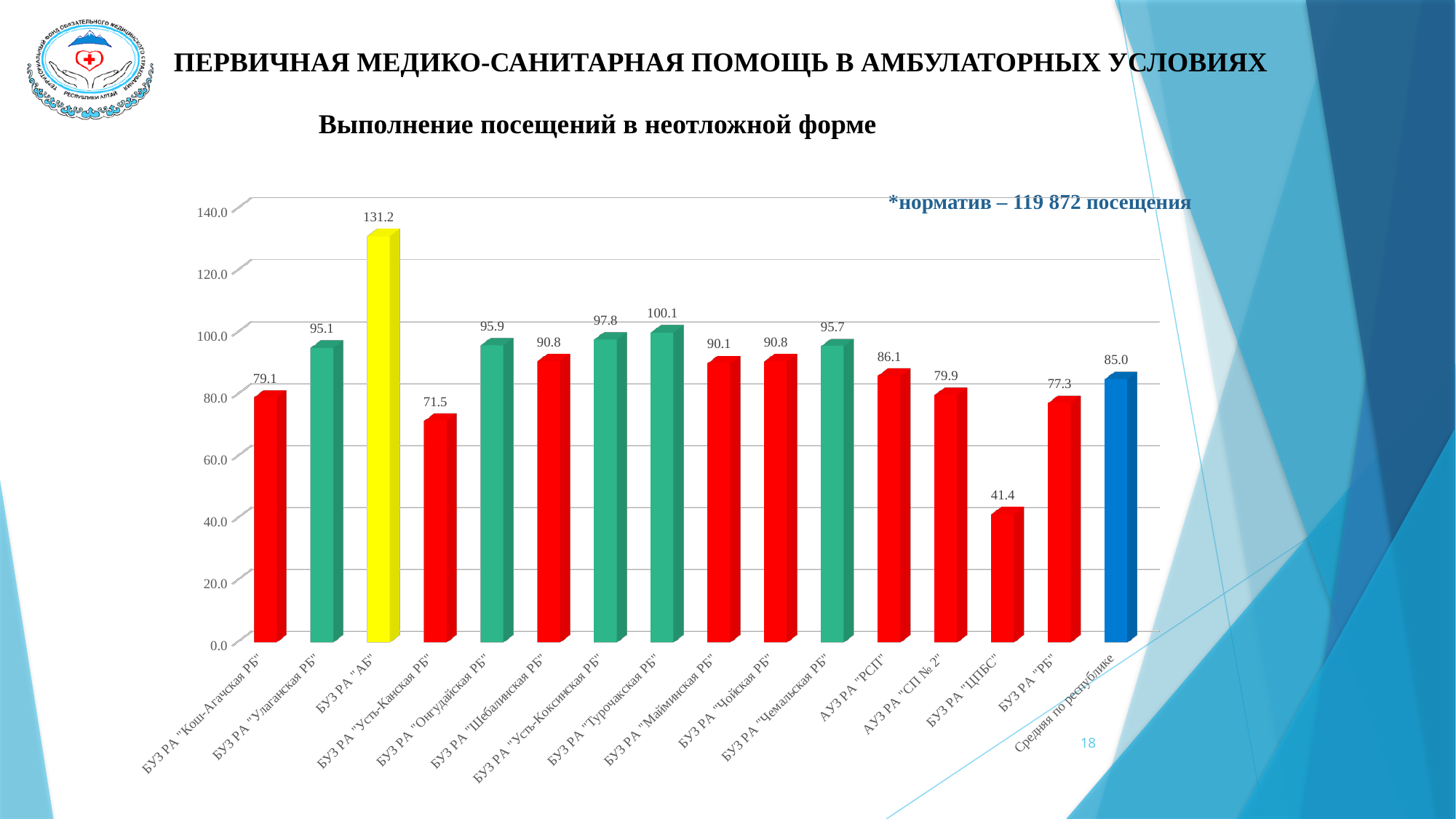
What kind of chart is shown on the slide? bar chart What is the title of the chart? Выполнение посещений в неотложной форме Which is larger, the value for БУЗ РА "Усть-Коксинская РБ" or БУЗ РА "Онгудайская РБ"? БУЗ РА "Усть-Коксинская РБ" Which category has the lowest value? БУЗ РА "ЦПБС" How many categories are shown on the x axis? 16 What value is shown for Средняя по республике? 85.0 What value is shown for БУЗ РА "Турочакская РБ"? 100.1 What is the difference between the values for БУЗ РА "АБ" and БУЗ РА "ЦПБС"? 89.8 Which category has the highest value? БУЗ РА "АБ" What value is shown for БУЗ РА "ЦПБС"? 41.4 Is the value for БУЗ РА "Усть-Канская РБ" greater or less than 80.0? less What colour is the bar for БУЗ РА "АБ"? yellow